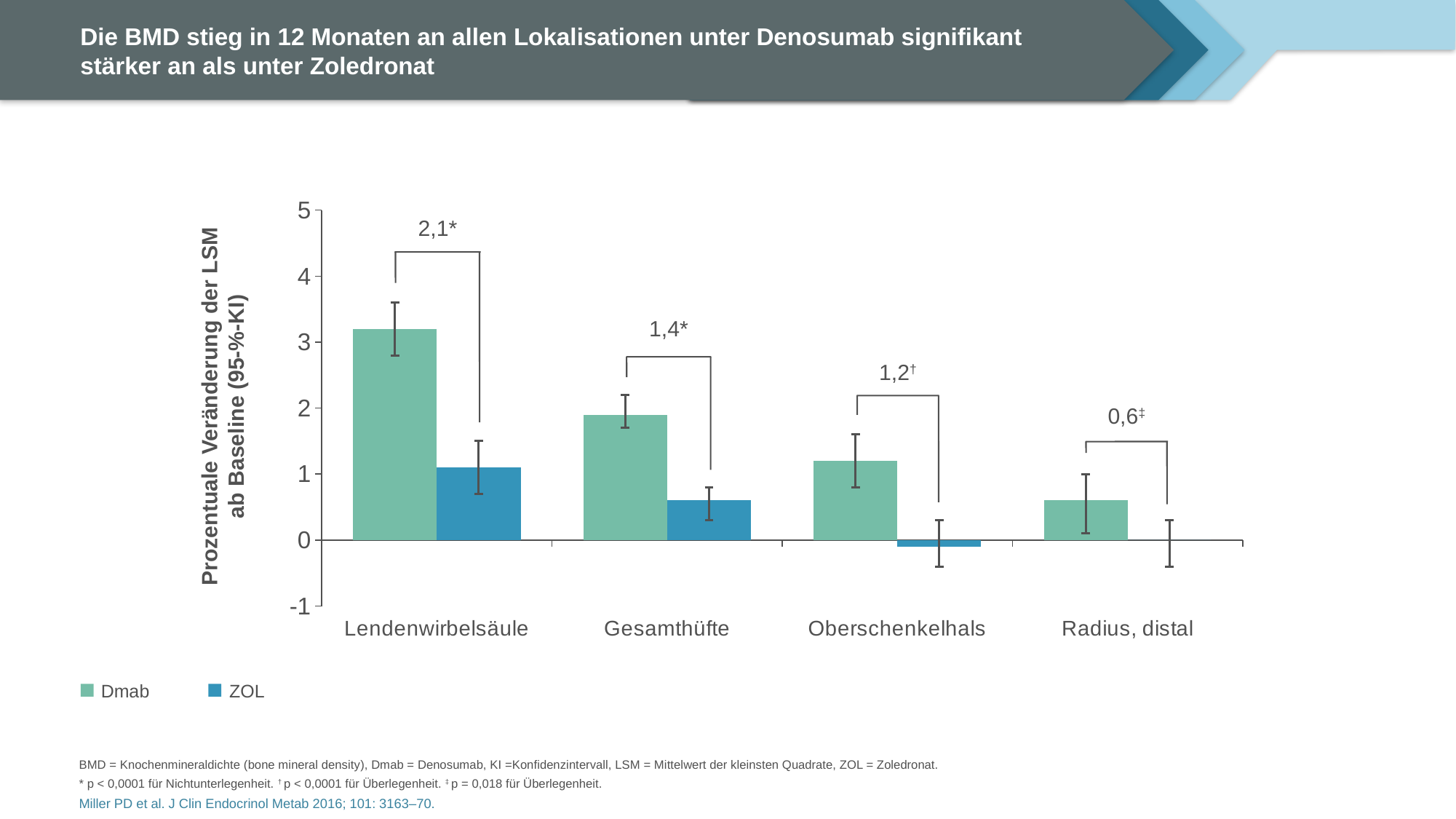
For which site is the Dmab bar the highest? Lendenwirbelsäule What difference between Dmab and ZOL is labelled above the Lendenwirbelsäule bars? 2,1 What difference between Dmab and ZOL is labelled above the Oberschenkelhals bars? 1,2 Which site has the smallest labelled difference between Dmab and ZOL? Radius, distal For which site is the Dmab bar the lowest? Radius, distal What kind of chart is shown on the slide? bar chart At Gesamthüfte, which series has the larger value, Dmab or ZOL? Dmab How many skeletal sites (categories) are shown on the x axis? 4 Which series does the legend list first? Dmab Is the ZOL value for Gesamthüfte greater or less than 1? less How many series does the legend list? 2 Is the Dmab value for Lendenwirbelsäule greater or less than 2? greater